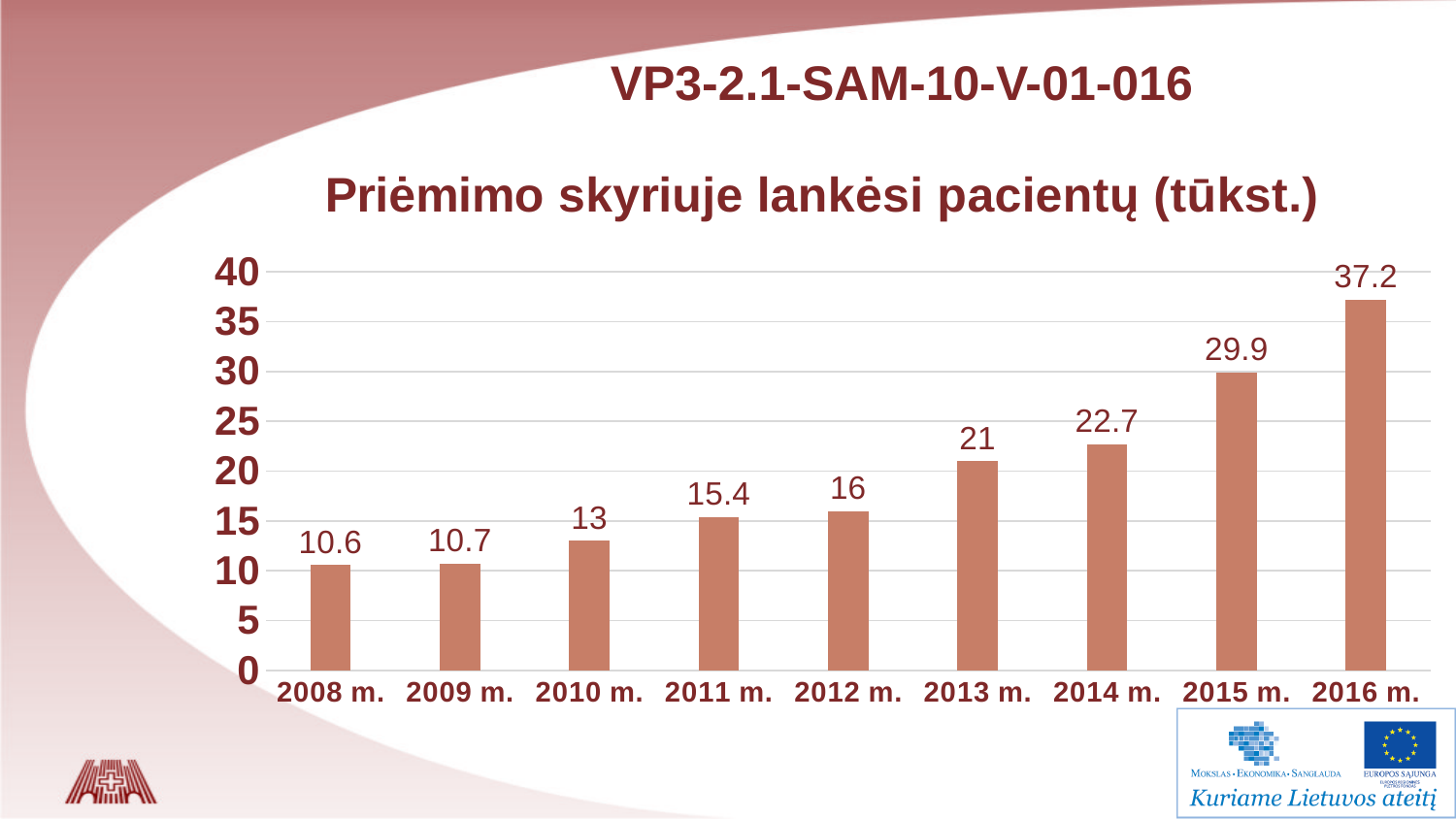
What kind of chart is shown on the slide? bar chart Which year has the lowest value? 2008 m. Which is larger, the value for 2014 m. or the value for 2013 m.? 2014 m. Do the values rise or fall from 2008 m. to 2016 m.? rise What is the value for 2008 m.? 10.6 How many years are shown on the x axis? 9 Which year has the highest value? 2016 m. What is the value for 2016 m.? 37.2 Is the value for 2015 m. greater or less than 25? greater What is the value for 2011 m.? 15.4 What is the difference between the values for 2016 m. and 2015 m.? 7.3 What is the difference between the values for 2013 m. and 2012 m.? 5